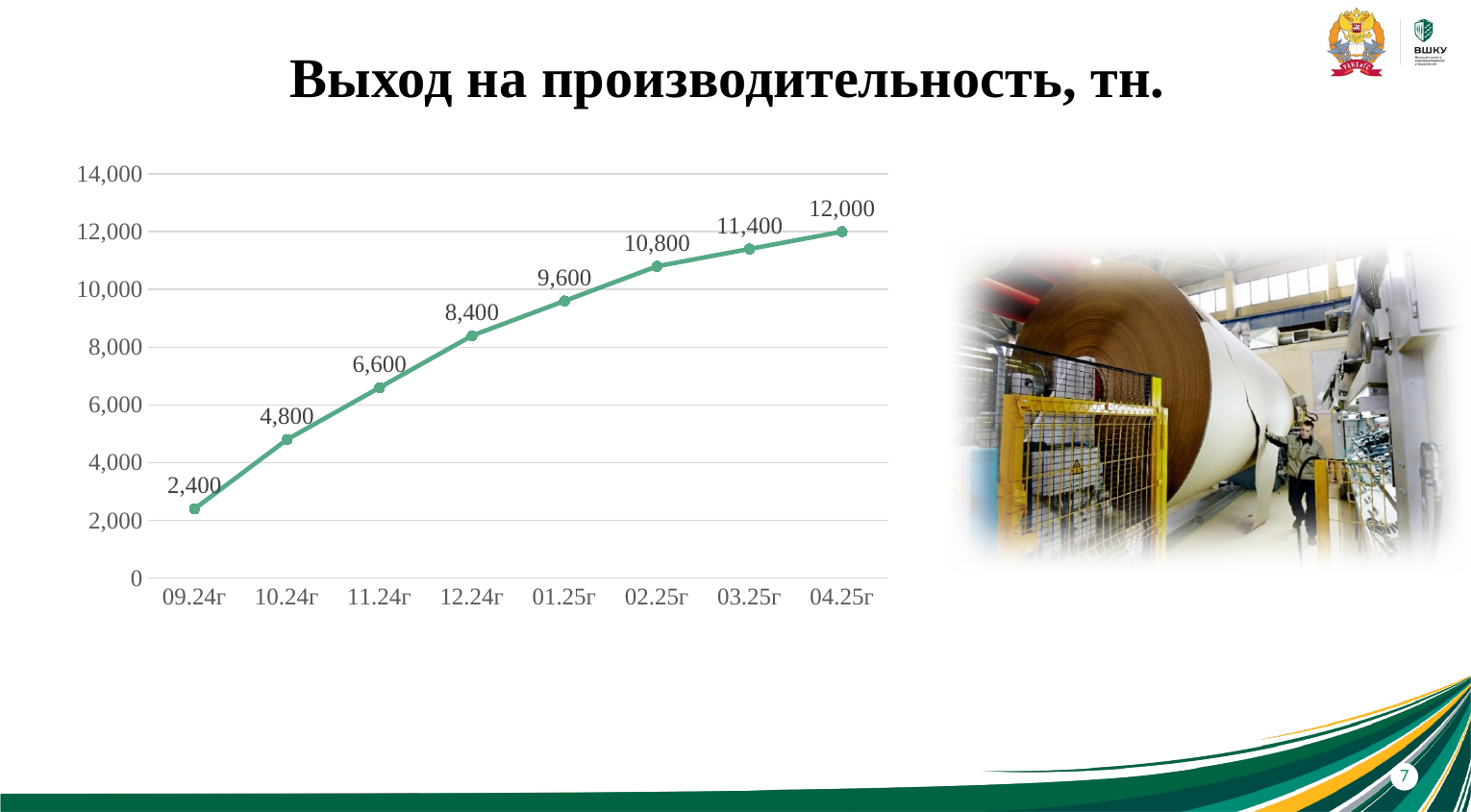
Is the value for 01.25г greater or less than 10,000? less Which is larger, the value for 01.25г or the value for 03.25г? 03.25г What is the value for 12.24г? 8,400 What is the value for 09.24г? 2,400 What is the difference between the values for 04.25г and 09.24г? 9,600 What kind of chart is shown on the slide? line chart Do the values rise or fall from 09.24г to 04.25г? rise What is the value for 02.25г? 10,800 Which period has the highest value? 04.25г Which period has the lowest value? 09.24г How many data points are plotted on the chart? 8 What is the difference between the values for 11.24г and 10.24г? 1,800